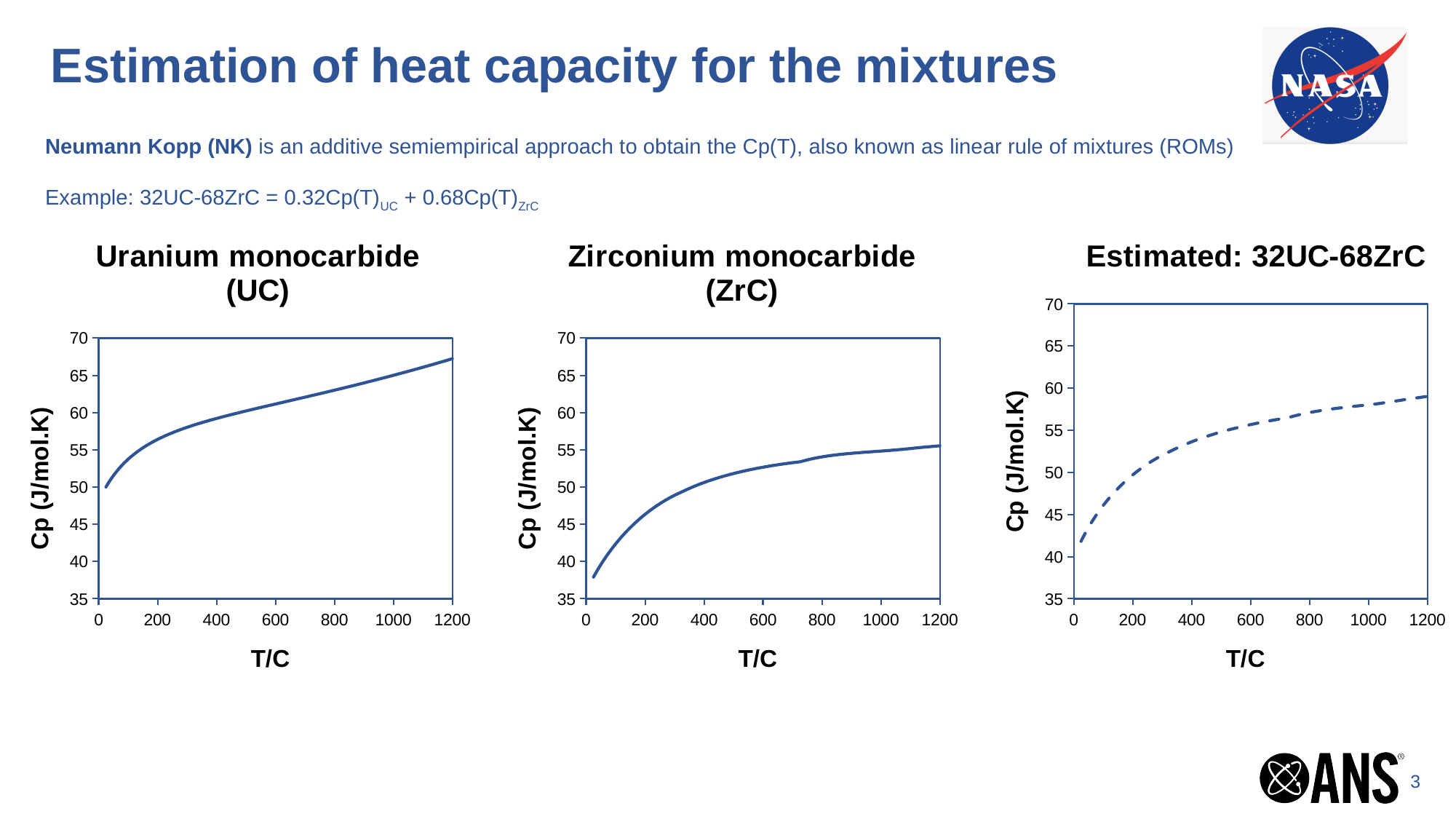
In the Zirconium monocarbide (ZrC) chart, does Cp rise or fall as T/C increases? rise In the Estimated: 32UC-68ZrC chart, does Cp rise or fall as T/C increases? rise In the Zirconium monocarbide (ZrC) chart, is the Cp value at T/C = 1200 greater or less than 50? greater What type of chart is the Uranium monocarbide (UC) chart? line chart In the Uranium monocarbide (UC) chart, is the Cp value at T/C = 1200 greater or less than 65? greater At T/C = 1200, which has the higher Cp: the Uranium monocarbide (UC) chart or the Zirconium monocarbide (ZrC) chart? Uranium monocarbide (UC) In the Uranium monocarbide (UC) chart, does Cp rise or fall as T/C increases? rise In the Estimated: 32UC-68ZrC chart, is the Cp value at T/C = 1200 greater or less than 55? greater What is the x-axis label on the Zirconium monocarbide (ZrC) chart? T/C What is the y-axis label on the Estimated: 32UC-68ZrC chart? Cp (J/mol.K)